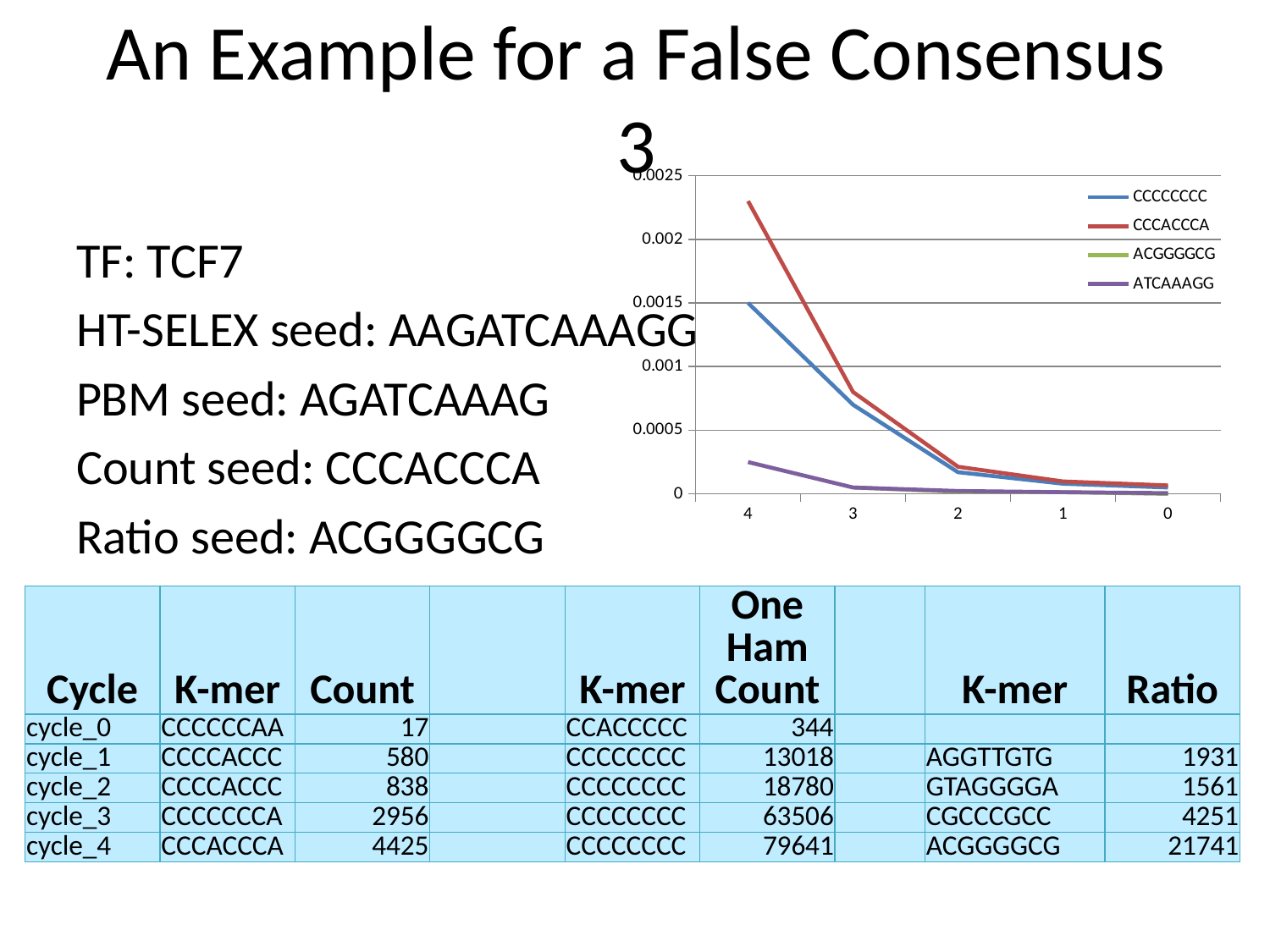
Which series is listed first in the chart's legend? CCCCCCCC Is the value for CCCACCCA at x = 4 greater or less than 0.002? greater Is the value for CCCCCCCC at x = 4 greater or less than 0.001? greater Is the value for ATCAAAGG at x = 4 greater or less than 0.0005? less How many series does the chart's legend list? 4 What kind of chart is shown on the slide? line chart Which series has the highest value at x = 4? CCCACCCA At x = 4, which is larger: the value for CCCACCCA or the value for ATCAAAGG? CCCACCCA Which series is drawn in red in the chart? CCCACCCA How many points are marked along the x axis of the chart? 5 Do the values for CCCACCCA rise or fall moving from left to right along the x axis? fall